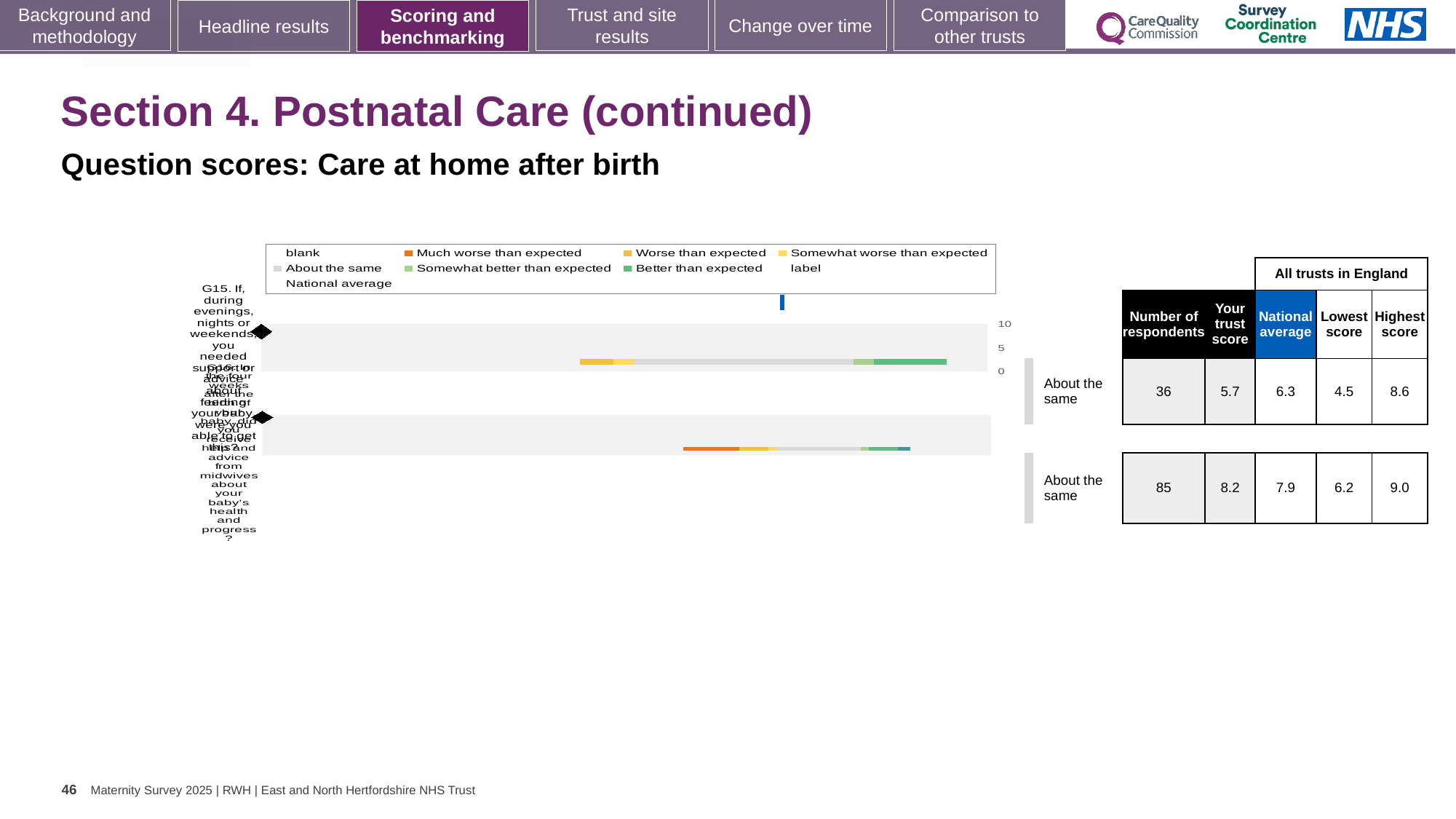
What benchmark category is shown for the second (bottom) question bar? About the same What is the number of respondents for the first (top) question bar, G15? 36 For the first (top) question bar, what is the difference between the highest score and the lowest score? 4.1 What kind of chart is shown on the slide? bar chart What is the trust score for the second (bottom) question bar? 8.2 Which question bar has the higher number of respondents, the top one or the bottom one? the bottom one Which legend entry is shown in orange? Much worse than expected What is the national average for the first (top) question bar, G15? 6.3 What is the highest score for the second (bottom) question bar? 9.0 For the first (top) question bar, which is larger: the trust score or the national average? National average For the second (bottom) question bar, what is the difference between the trust score and the national average? 0.3 How many question bars are plotted in the chart? 2